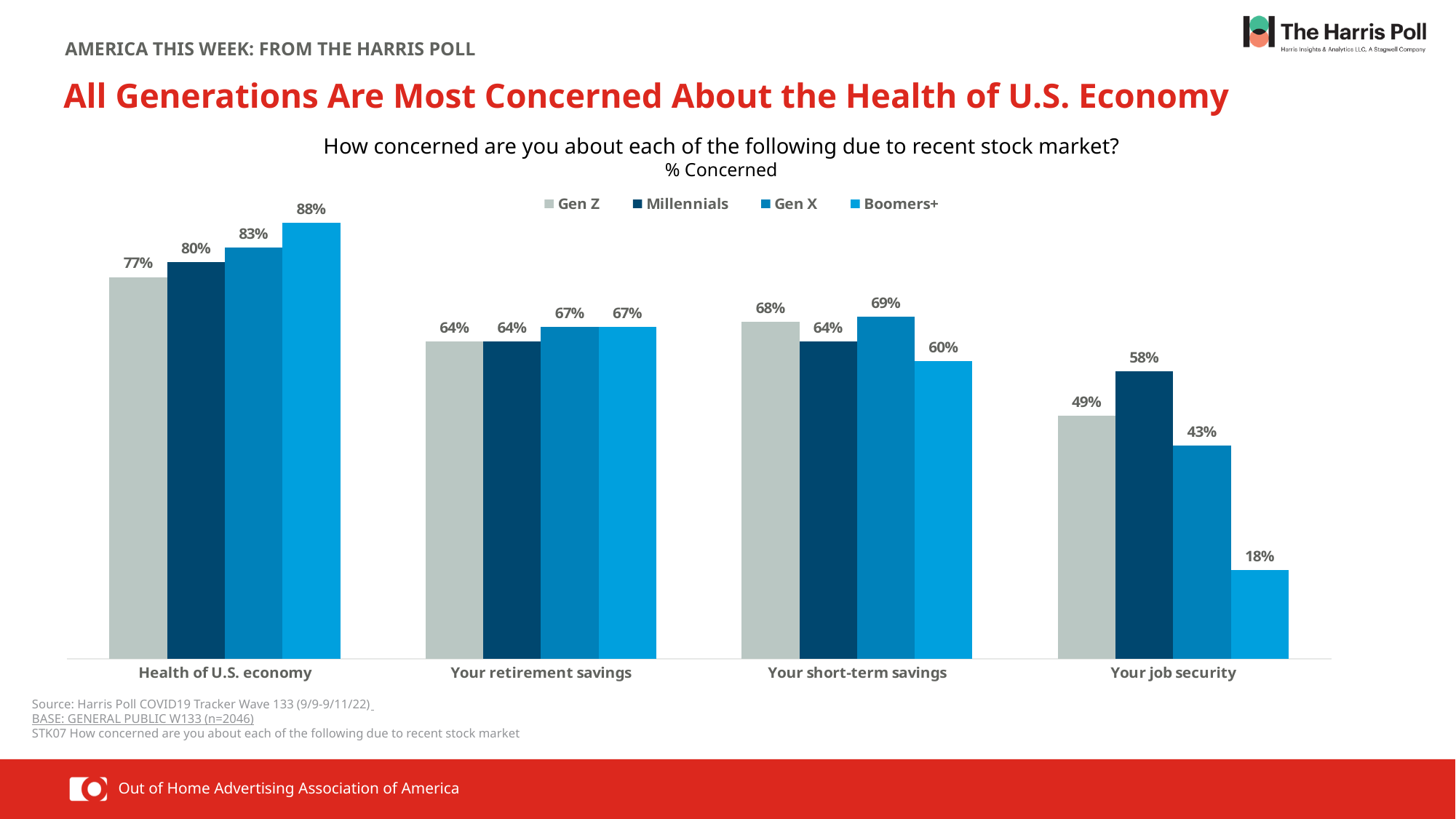
Which is larger: Gen X concern about short-term savings or Boomers+ concern about short-term savings? Gen X What is the difference between Millennials and Boomers+ concern about job security? 40% How many series does the legend list? 4 What kind of chart is shown on the slide? Bar chart What percentage of Millennials are concerned about their short-term savings? 64% How many categories are shown on the x axis? 4 Which generation has the lowest concern about the health of the U.S. economy? Gen Z Which generation has the highest concern about job security? Millennials What is the difference between Boomers+ and Gen Z concern about the health of the U.S. economy? 11% What percentage of Gen Z are concerned about their job security? 49% What percentage of Boomers+ are concerned about the health of the U.S. economy? 88% What is the subtitle shown below the question text above the chart? % Concerned